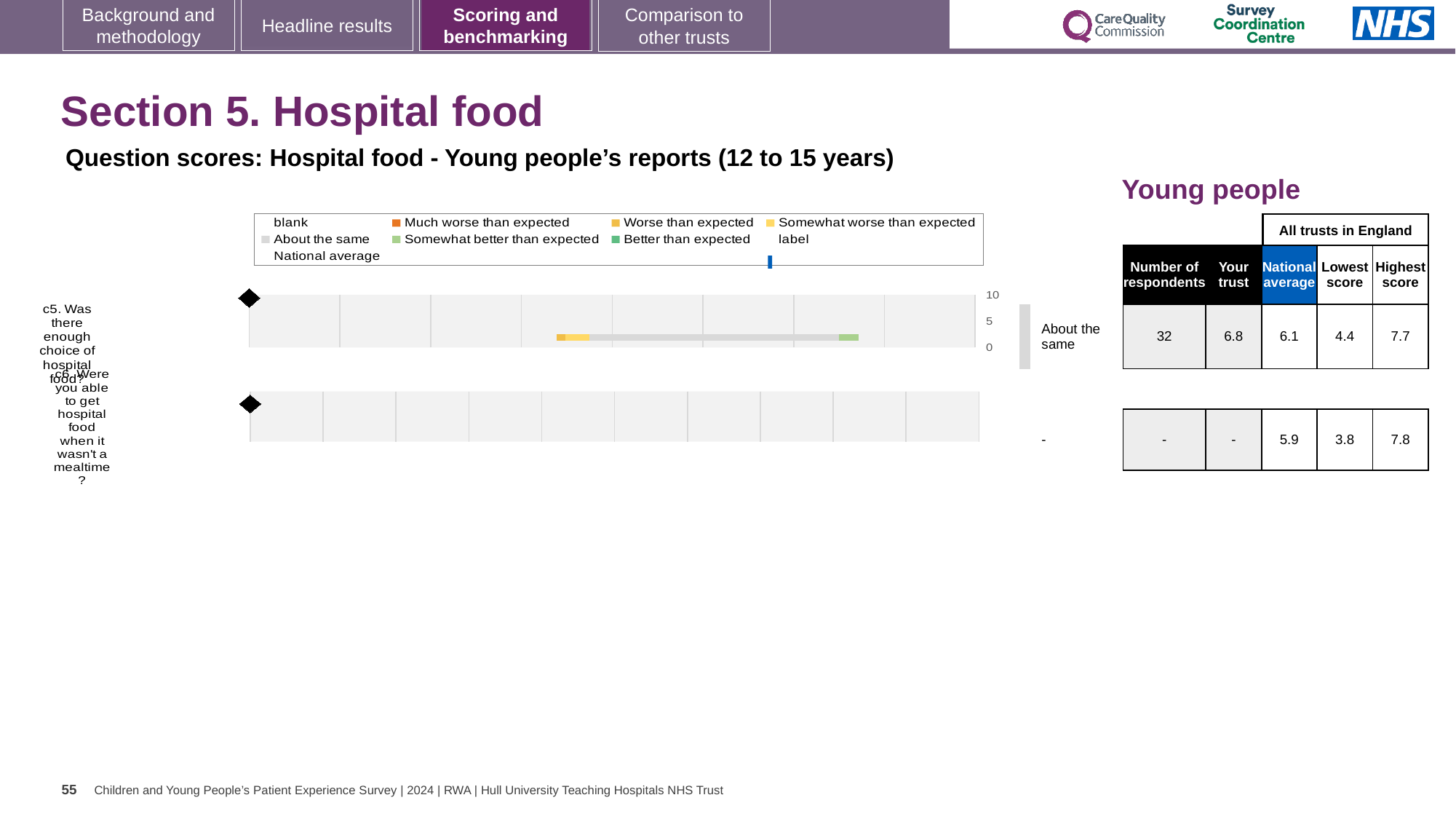
What is the highest score among all trusts in England for question c6? 7.8 What is the maximum value shown on the chart's score axis? 10 How many respondents answered question c5 'Was there enough choice of hospital food?' 32 What is the national average score for question c6 'Were you able to get hospital food when it wasn't a mealtime?' 5.9 By how much does the trust's score for c5 exceed the national average for c5? 0.7 What is the national average score for question c5 'Was there enough choice of hospital food?' 6.1 Which is larger for question c5: the trust's score or the national average? Your trust What is the highest score among all trusts in England for question c5? 7.7 What is the 'Your trust' score for question c5 'Was there enough choice of hospital food?' 6.8 What is the benchmark category shown for question c5? About the same What is the lowest score among all trusts in England for question c5? 4.4 How many survey questions are plotted on the chart? 2